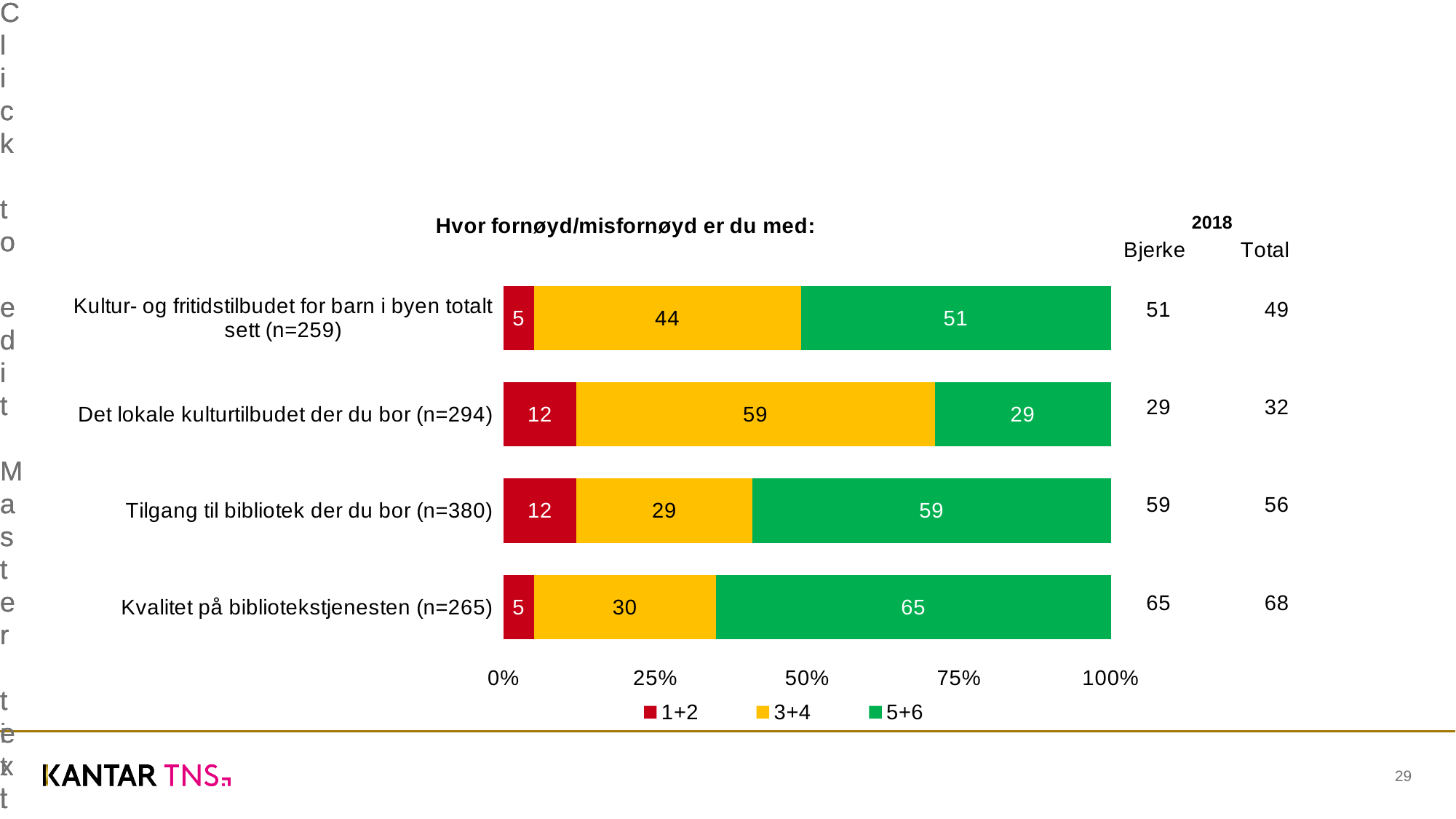
Which category has the highest value for the 5+6 series? Kvalitet på bibliotekstjenesten (n=265) How many categories are shown in the chart? 4 What kind of chart is shown on the slide? Stacked bar chart What is the title of the chart? Hvor fornøyd/misfornøyd er du med: What is the value of the 1+2 series for "Tilgang til bibliotek der du bor (n=380)"? 12 How many series does the legend list? 3 What is the value of the 5+6 series for "Kvalitet på bibliotekstjenesten (n=265)"? 65 Which is larger: the 3+4 value for "Kultur- og fritidstilbudet for barn i byen totalt sett (n=259)" or the 3+4 value for "Kvalitet på bibliotekstjenesten (n=265)"? Kultur- og fritidstilbudet for barn i byen totalt sett (n=259) What is the total of the stacked bar for "Det lokale kulturtilbudet der du bor (n=294)"? 100 Which category has the lowest value for the 5+6 series? Det lokale kulturtilbudet der du bor (n=294) What is the value of the 3+4 series for "Det lokale kulturtilbudet der du bor (n=294)"? 59 What is the difference between the 5+6 values for "Tilgang til bibliotek der du bor (n=380)" and "Det lokale kulturtilbudet der du bor (n=294)"? 30